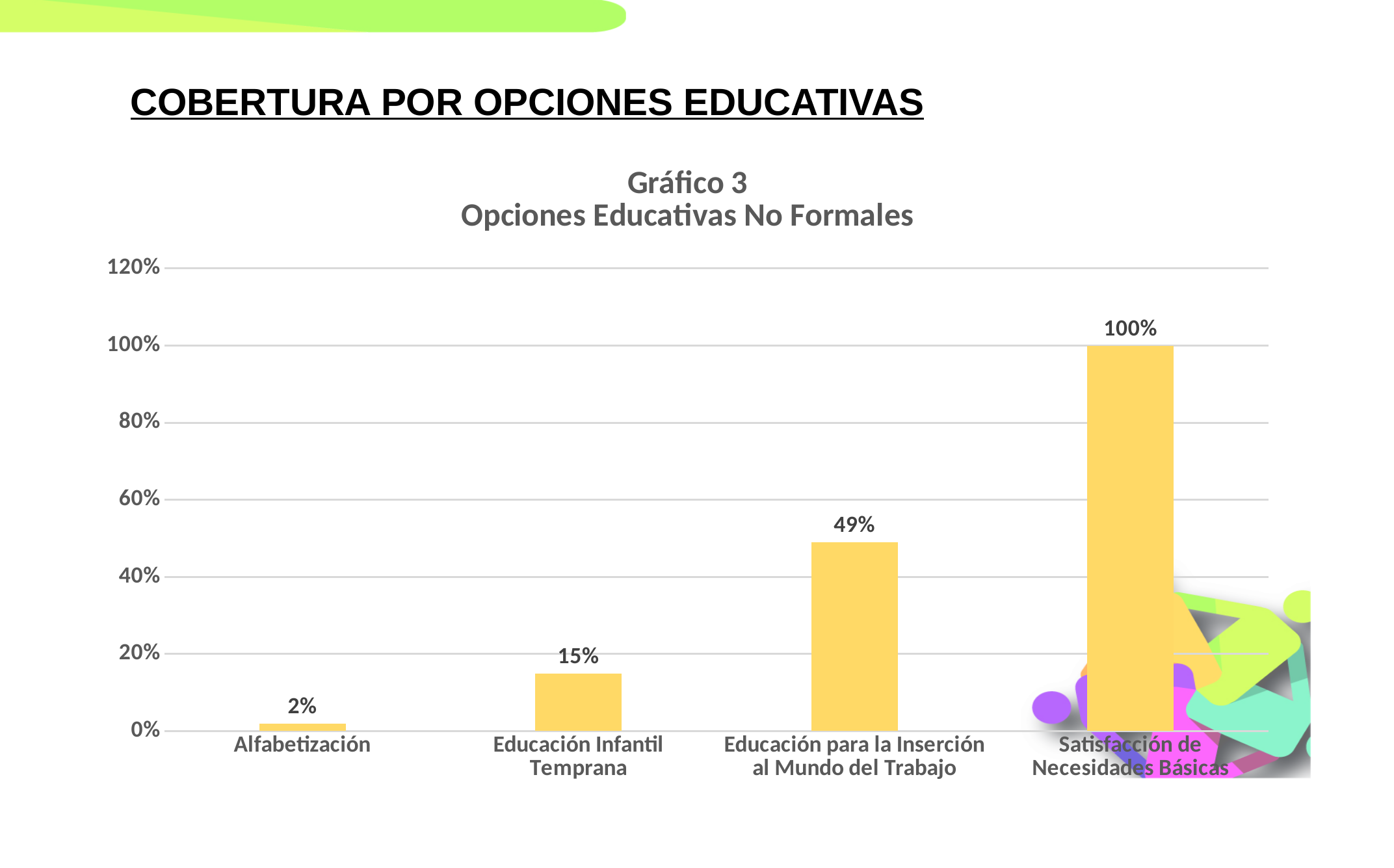
Which category has the lowest value? Alfabetización What is the value for Educación para la Inserción al Mundo del Trabajo? 49% Which is larger, the value for Educación Infantil Temprana or the value for Alfabetización? Educación Infantil Temprana Is the value for Educación para la Inserción al Mundo del Trabajo greater or less than 40%? greater How many categories are shown in the chart? 4 What kind of chart is shown on the slide? bar chart What is the difference between the values for Satisfacción de Necesidades Básicas and Educación para la Inserción al Mundo del Trabajo? 51% What is the value for Alfabetización? 2% Which category has the highest value? Satisfacción de Necesidades Básicas What is the title of the chart? Gráfico 3 Opciones Educativas No Formales What is the value for Satisfacción de Necesidades Básicas? 100% What is the value for Educación Infantil Temprana? 15%